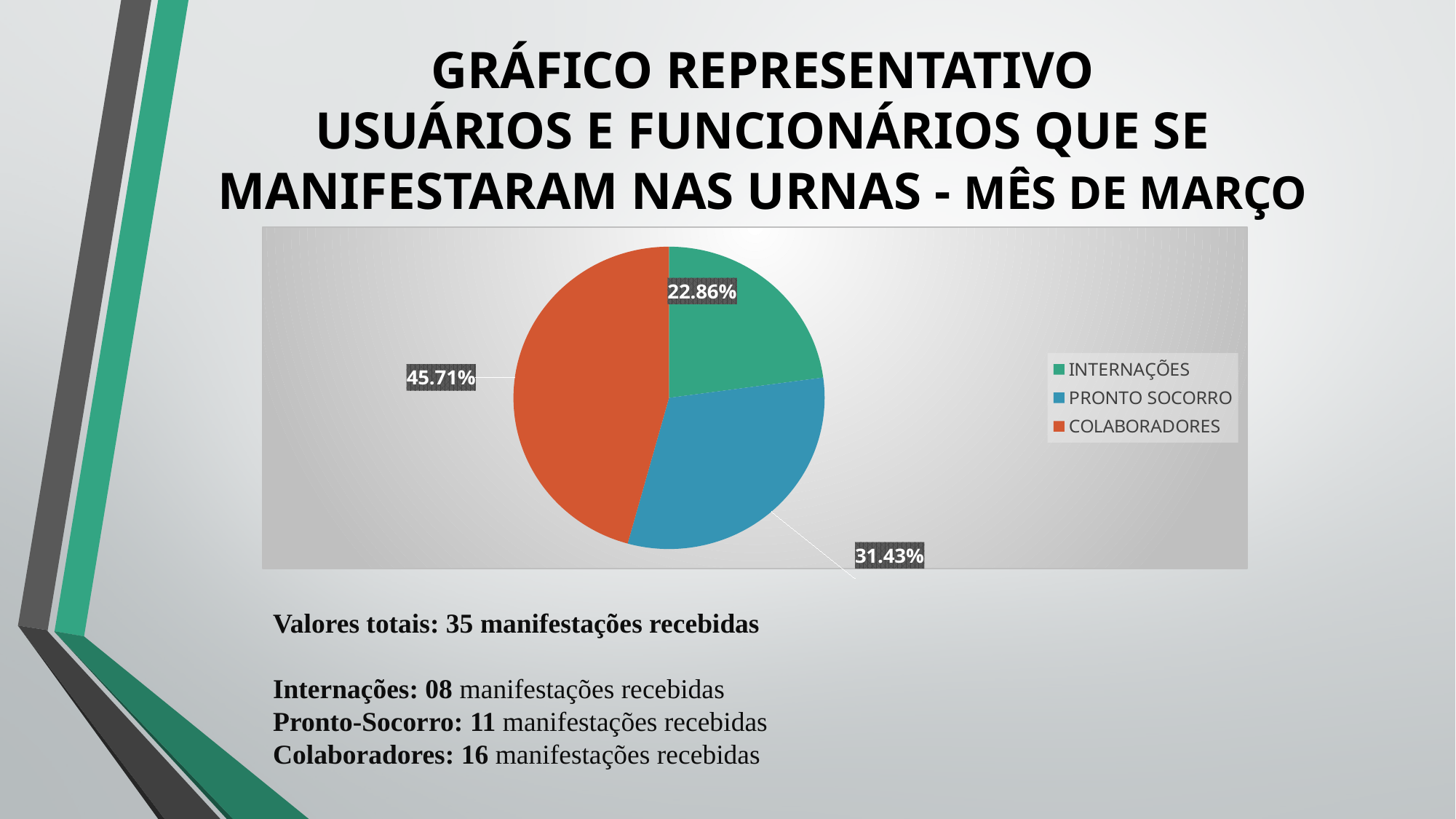
What percentage share does the PRONTO SOCORRO slice have? 31.43% What percentage share does the COLABORADORES slice have? 45.71% Which category has the largest slice of the pie? COLABORADORES What colour is the COLABORADORES slice? orange Which legend entry is shown in blue? PRONTO SOCORRO Which category has the smallest slice of the pie? INTERNAÇÕES How many entries does the legend list? 3 What is the difference in percentage points between the COLABORADORES slice and the INTERNAÇÕES slice? 22.85 Which slice is larger, PRONTO SOCORRO or INTERNAÇÕES? PRONTO SOCORRO How many categories does the pie chart show? 3 What type of chart is shown on the slide? pie chart What percentage share does the INTERNAÇÕES slice have? 22.86%